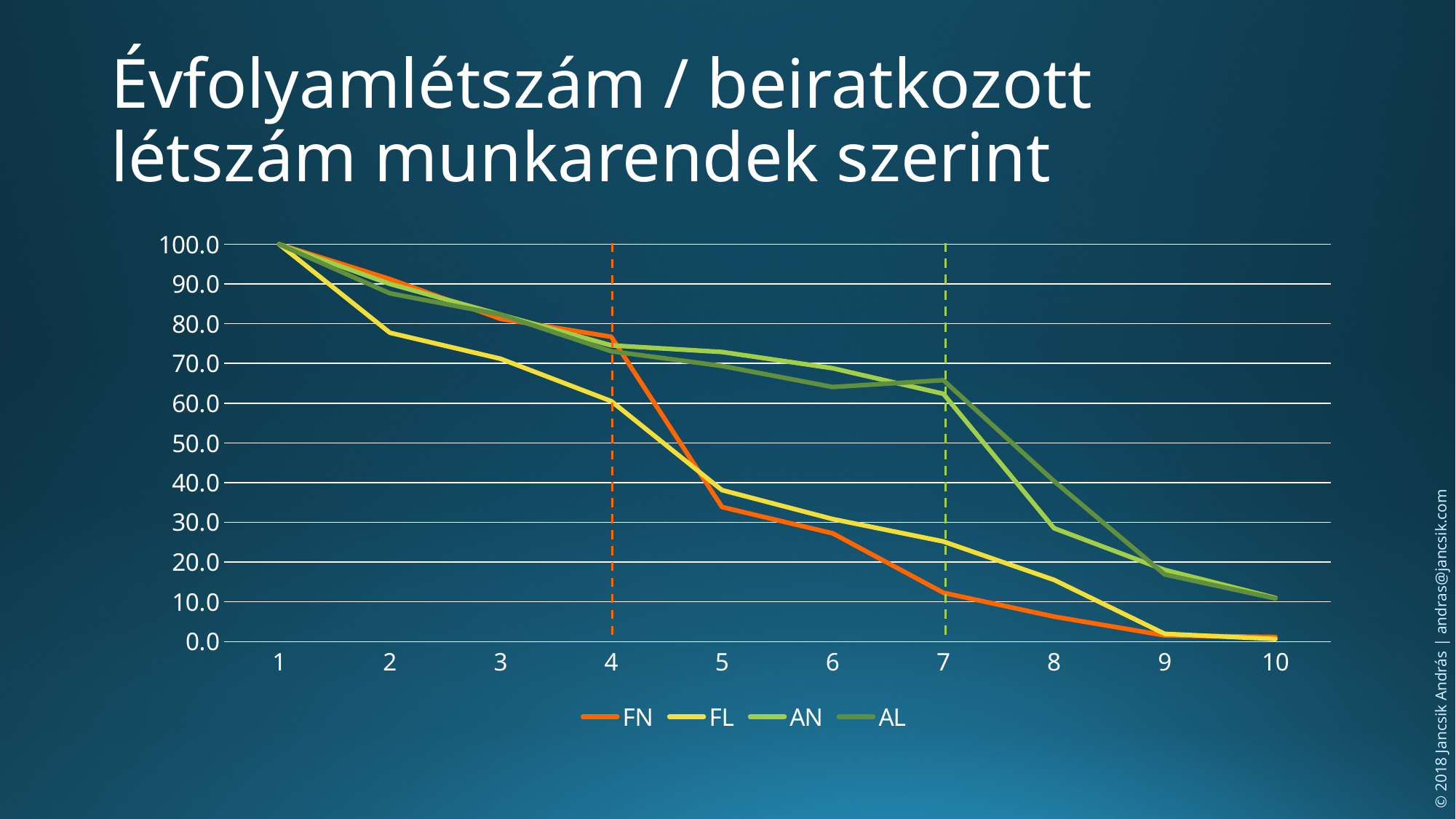
At x = 8, which series is larger, AL or AN? AL How many points are there along the x axis? 10 Which colour is used for the FN series in the legend? orange Which series has the lowest value at x = 7? FN How many series does the legend list? 4 Do the values of the FL series rise or fall as x increases from 1 to 10? fall Is the value for AL at x = 8 greater or less than 50? less What kind of chart is shown on the slide? line chart Is the value for AN at x = 6 greater or less than 60? greater What is the value of the FN series at x = 1? 100.0 Is the value for FL at x = 2 greater or less than 80? less